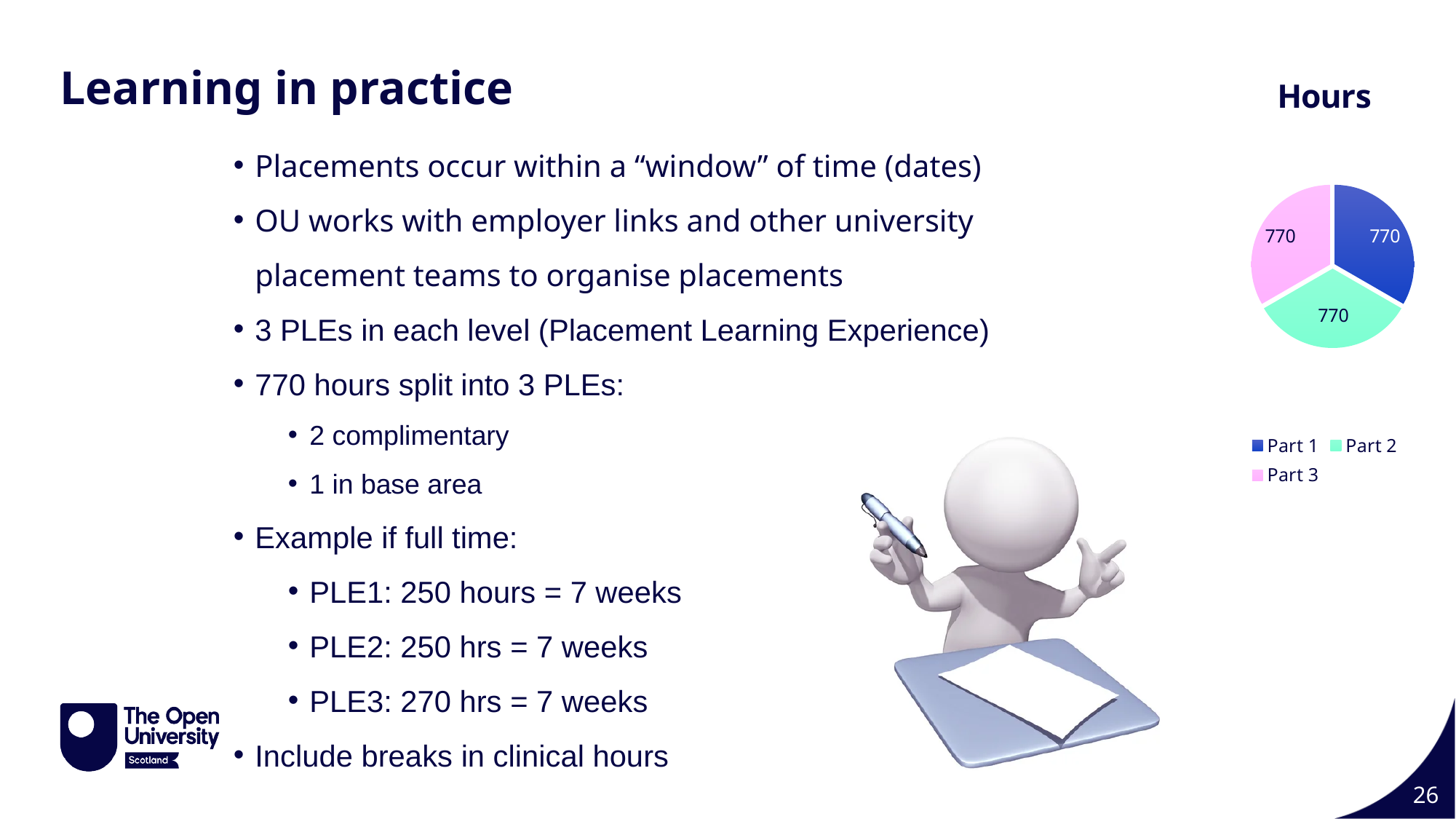
Is the value for Part 1 greater or less than 500? greater What is the total of all three slices in the pie chart? 2310 What is the title of the chart? Hours What is the value shown for Part 1? 770 Which colour represents Part 3 in the pie chart? pink How many entries does the chart legend list? 3 What is the difference between the values for Part 1 and Part 3? 0 What is the value shown for Part 2? 770 How many slices does the pie chart have? 3 What is the value shown for Part 3? 770 What share of the pie does Part 2 represent? one third What kind of chart is shown on the slide? pie chart